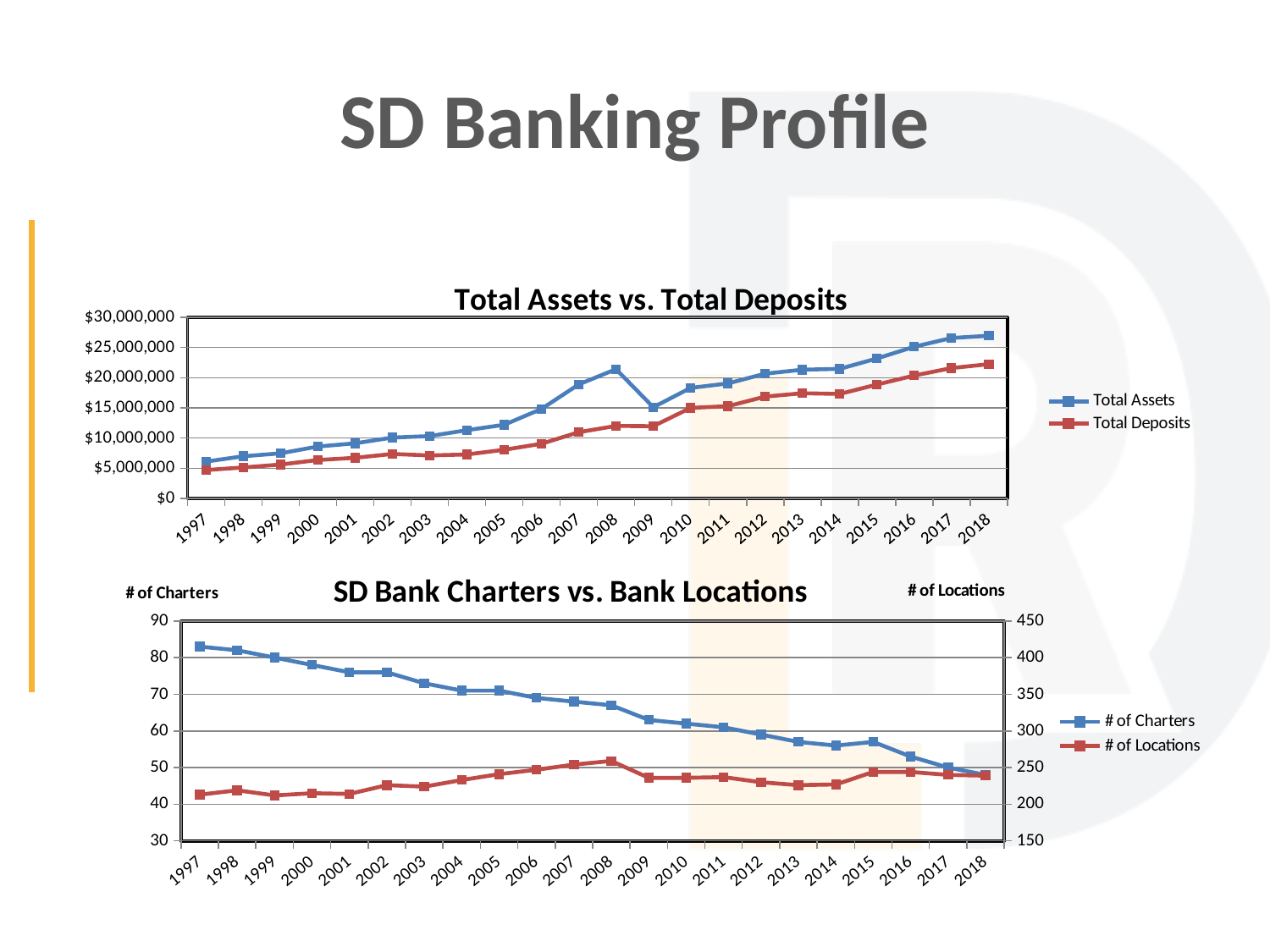
In the "Total Assets vs. Total Deposits" chart, is the Total Deposits value for 1997 greater or less than $10,000,000? less What kind of chart is the "Total Assets vs. Total Deposits" chart? Line chart In the "SD Bank Charters vs. Bank Locations" chart, is the # of Charters for 1997 greater or less than 80? greater In the "SD Bank Charters vs. Bank Locations" chart, do the # of Charters values rise or fall from 1997 to 2018? Fall In the "Total Assets vs. Total Deposits" chart, is Total Assets larger in 2008 or in 2009? 2008 How many years are shown on the x axis of the "Total Assets vs. Total Deposits" chart? 22 How many series does the legend of the "SD Bank Charters vs. Bank Locations" chart list? 2 In the "Total Assets vs. Total Deposits" chart, which year has the highest Total Assets value? 2018 What is the title of the lower chart on the slide? SD Bank Charters vs. Bank Locations In the "Total Assets vs. Total Deposits" chart, is the Total Assets value for 2018 greater or less than $25,000,000? greater In the "SD Bank Charters vs. Bank Locations" chart, which year has the highest # of Charters? 1997